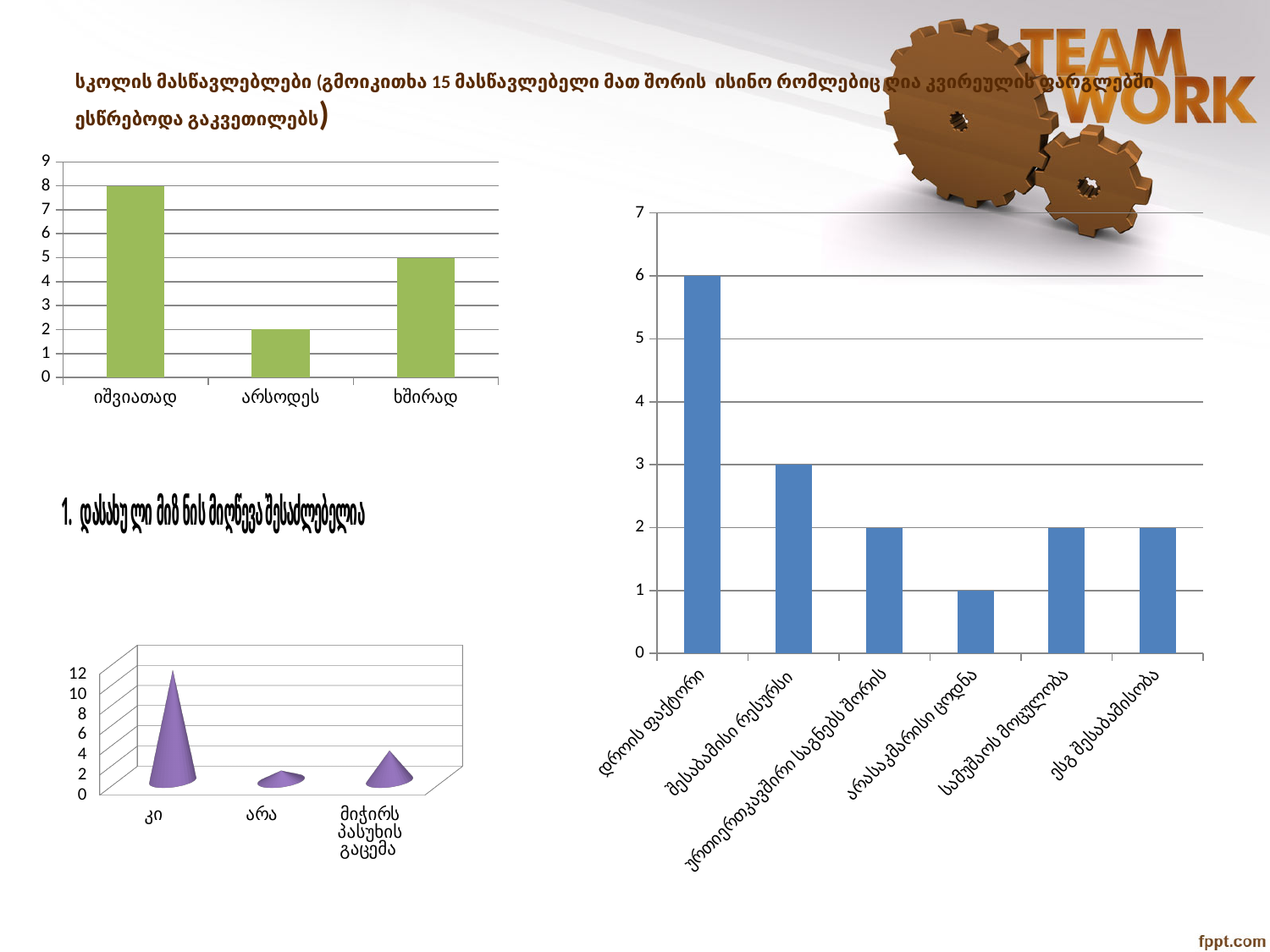
In the bottom-left chart, which category has the highest value? კი In the top-left bar chart, what is the value for იშვიათად? 8 In the top-left bar chart, what is the value for არსოდეს? 2 In the right-hand bar chart, which is larger: the value for დროის ფაქტორი or the value for სამუშაოს მოცულობა? დროის ფაქტორი In the top-left bar chart, how many categories are shown? 3 In the top-left bar chart, what is the difference between the values for იშვიათად and ხშირად? 3 In the right-hand bar chart, how many categories are shown? 6 In the right-hand bar chart, what is the value for დროის ფაქტორი? 6 In the right-hand bar chart, what is the value for შესაბამისი რესურსი? 3 In the top-left bar chart, which category has the highest value? იშვიათად In the bottom-left chart, is the value for კი greater or less than 10? greater In the right-hand bar chart, which category has the lowest value? არასაკმარისი ცოდნა